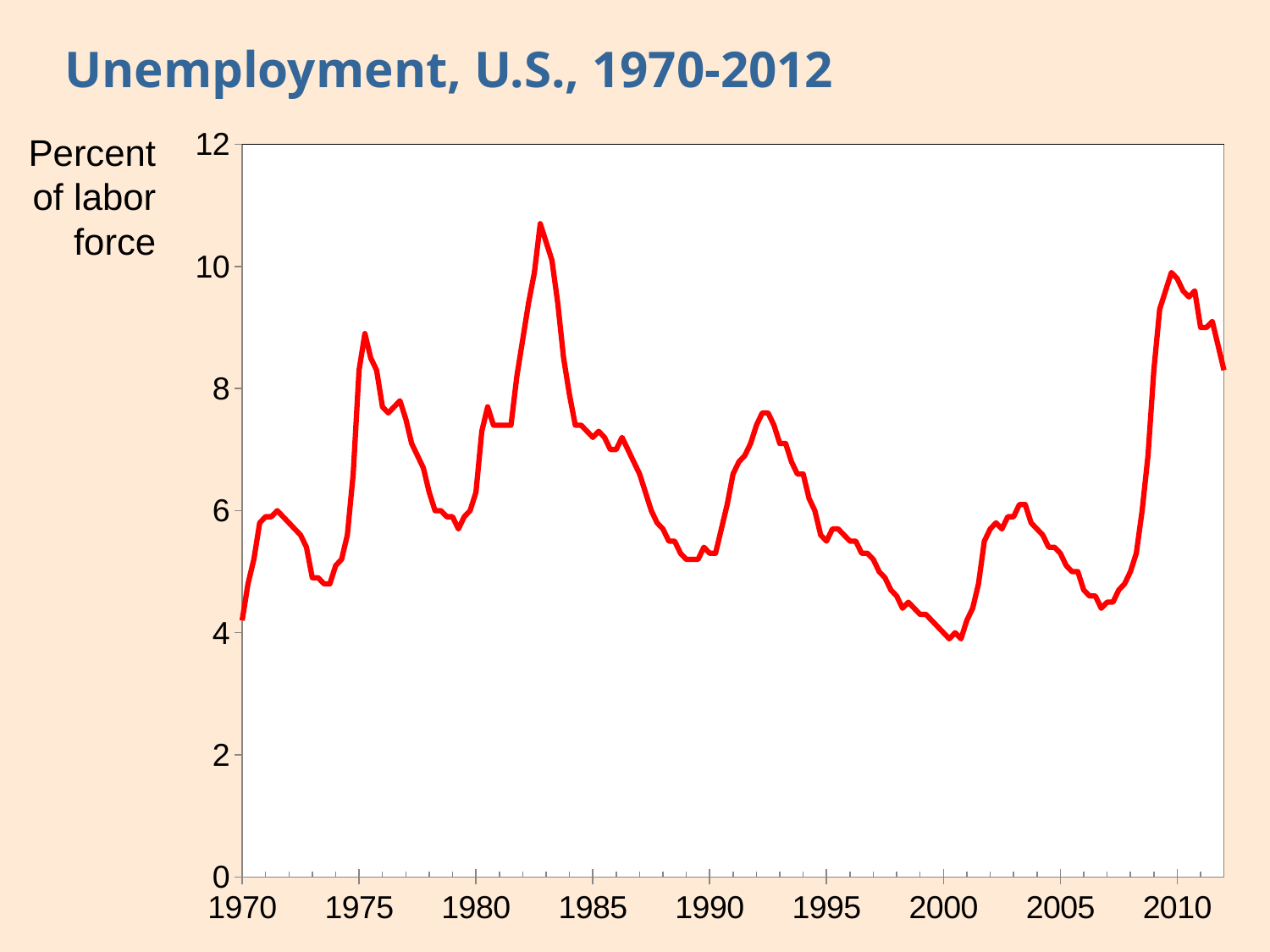
Is the peak unemployment rate around 1983 greater or less than 10? greater Is the unemployment rate in 2000 greater or less than 6? less Around which year does the unemployment rate reach its lowest point on the chart? 2000 Is the unemployment rate in 1970 greater or less than 6? less What does the vertical axis of the chart measure, according to its label? Percent of labor force What is the title of the chart? Unemployment, U.S., 1970-2012 What kind of chart is shown on the slide? line chart Around which year does the unemployment rate reach its highest point on the chart? 1983 Which peak is higher: the one around 1983 or the one around 2010? 1983 Does the unemployment rate rise or fall between 2007 and 2010? rise